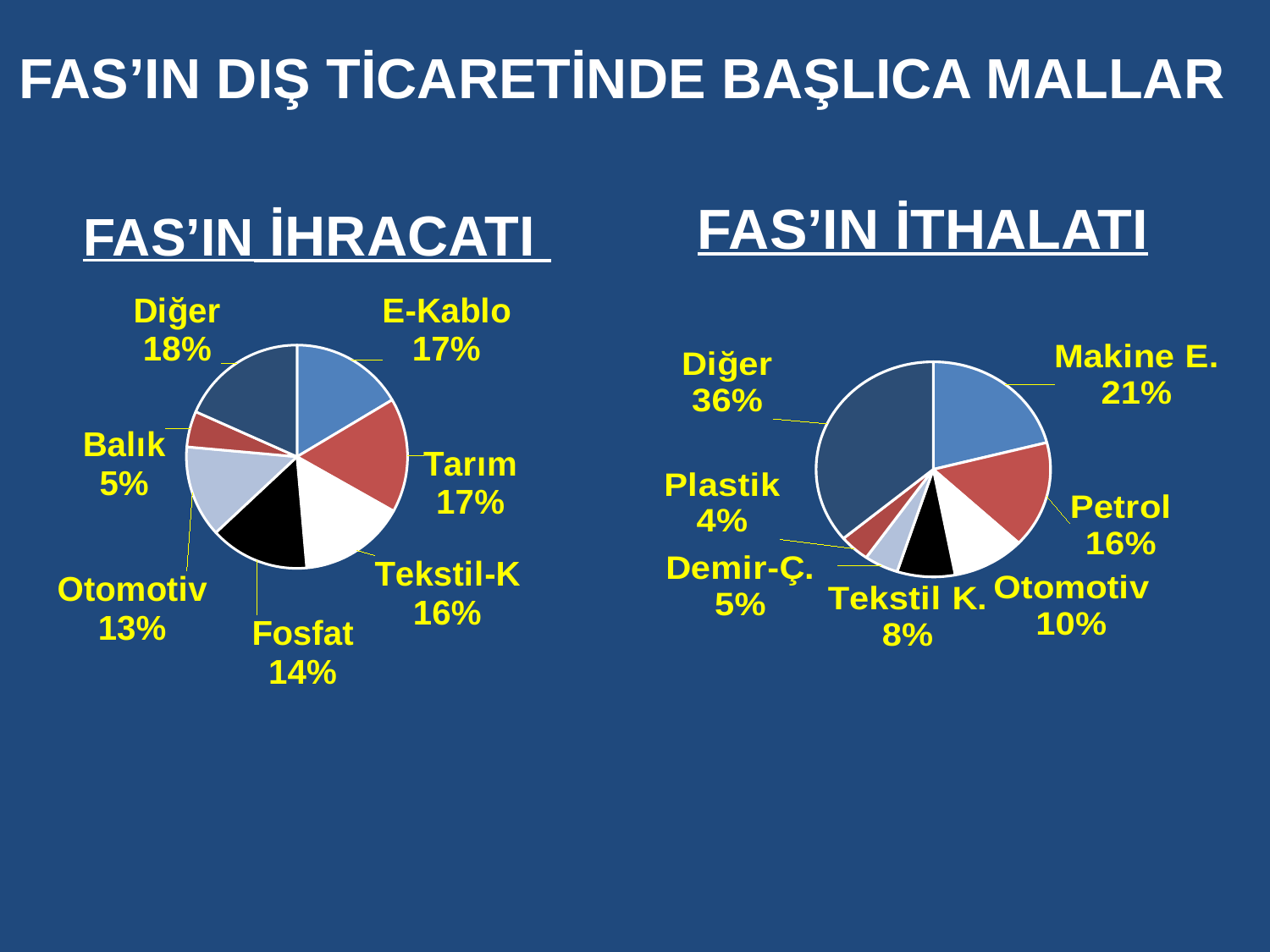
In the FAS'IN İTHALATI chart, what is the difference between Diğer and Makine E.? 15% In the FAS'IN İHRACATI chart, which category has the largest share? Diğer In the FAS'IN İTHALATI chart, which is larger, Petrol or Otomotiv? Petrol In the FAS'IN İHRACATI chart, what is the share for Fosfat? 14% In the FAS'IN İTHALATI chart, what is the share for Makine E.? 21% In the FAS'IN İTHALATI chart, which category has the smallest share? Plastik In the FAS'IN İHRACATI chart, what is the difference between Diğer and Otomotiv? 5% In the FAS'IN İHRACATI chart, how many categories are shown? 7 What type of chart is used for FAS'IN İHRACATI? Pie chart In the FAS'IN İHRACATI chart, which category has the smallest share? Balık In the FAS'IN İHRACATI chart, what is the share for Balık? 5% In the FAS'IN İTHALATI chart, what is the share for Demir-Ç.? 5%